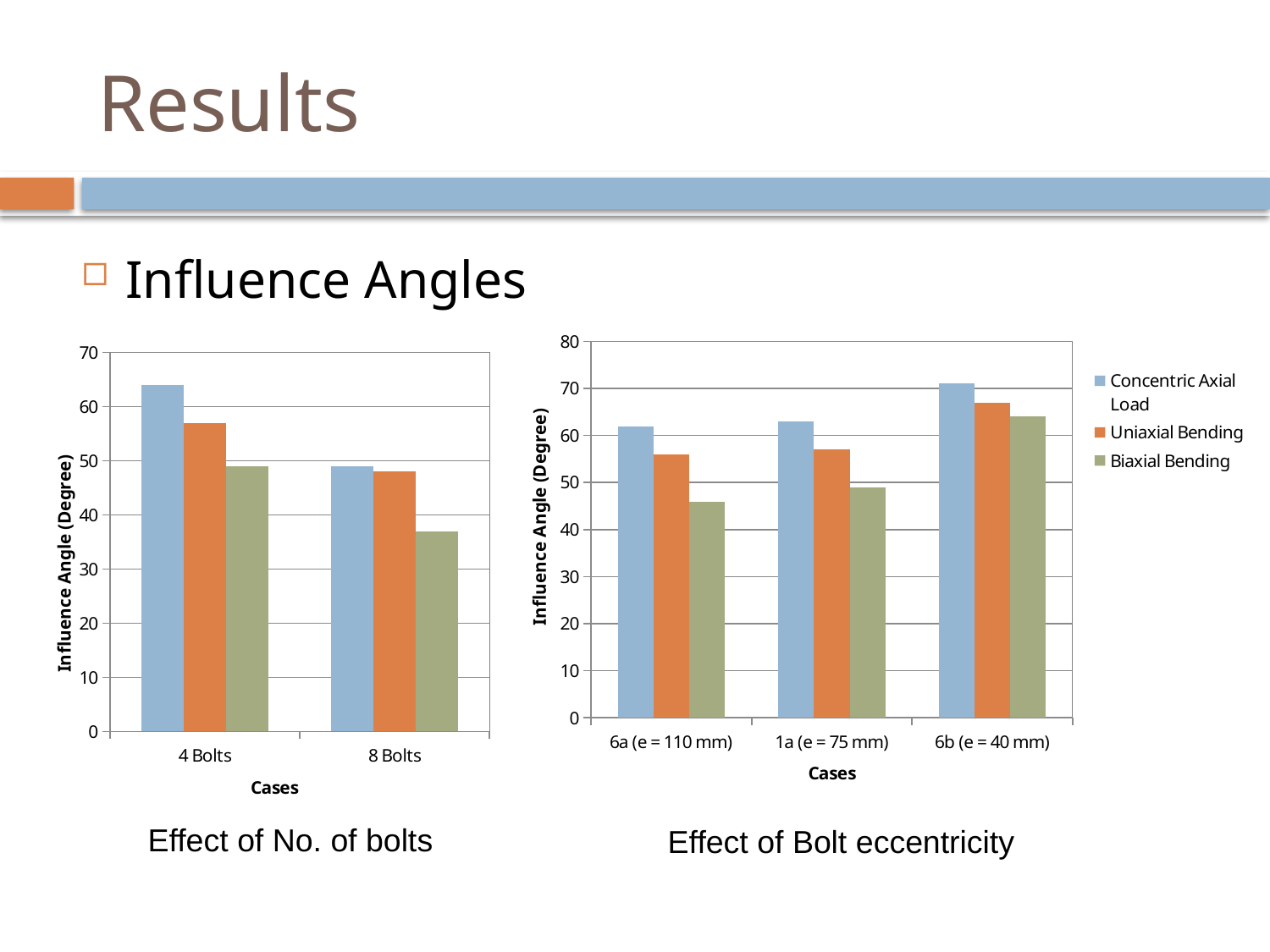
In the 'Effect of No. of bolts' chart, which has the larger Biaxial Bending influence angle, 4 Bolts or 8 Bolts? 4 Bolts In the 'Effect of Bolt eccentricity' chart, which case has the highest Concentric Axial Load influence angle? 6b (e = 40 mm) In the 'Effect of No. of bolts' chart, is the Biaxial Bending value for 8 Bolts greater or less than 40? less What is the y-axis title of the 'Effect of Bolt eccentricity' chart? Influence Angle (Degree) In the 'Effect of Bolt eccentricity' chart, which case has the lowest Biaxial Bending influence angle? 6a (e = 110 mm) In the 'Effect of No. of bolts' chart, is the Concentric Axial Load value for 4 Bolts greater or less than 60? greater In the 'Effect of Bolt eccentricity' chart, do the Biaxial Bending values rise or fall from 6a (e = 110 mm) to 6b (e = 40 mm)? rise How many cases are shown on the x axis of the 'Effect of No. of bolts' chart? 2 How many series does the legend of the 'Effect of Bolt eccentricity' chart list? 3 What kind of chart is the 'Effect of No. of bolts' chart on the left? bar chart In the 'Effect of Bolt eccentricity' chart, which series is shown in orange? Uniaxial Bending In the 'Effect of Bolt eccentricity' chart, is the Biaxial Bending value for 6a (e = 110 mm) greater or less than 50? less